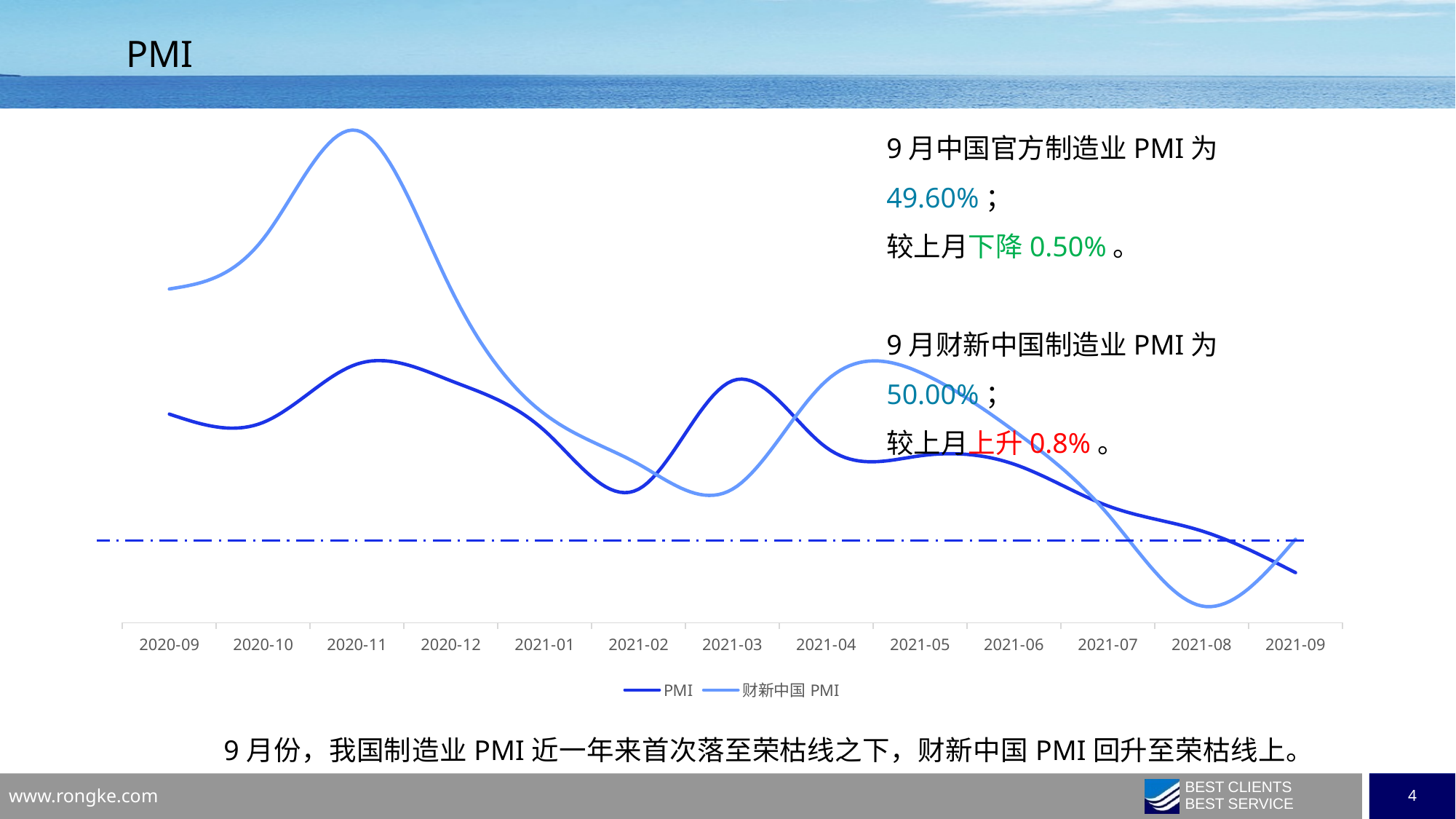
What are the two series named in the legend? PMI and 财新中国 PMI In 2020-11, which series is higher, PMI or 财新中国 PMI? 财新中国 PMI What kind of chart is shown on the slide? line chart According to the slide, what is the 财新中国 manufacturing PMI for September 2021? 50.00% In which month does the 财新中国 PMI series reach its highest point? 2020-11 How many months are shown along the x axis? 13 In which month does the 财新中国 PMI series reach its lowest point? 2021-08 Does the 财新中国 PMI series rise or fall from 2021-04 to 2021-08? fall In 2021-03, which series is higher, PMI or 财新中国 PMI? PMI According to the slide, what is the official China manufacturing PMI for September 2021? 49.60% In which month does the PMI series reach its lowest point? 2021-09 How many series does the legend list? 2